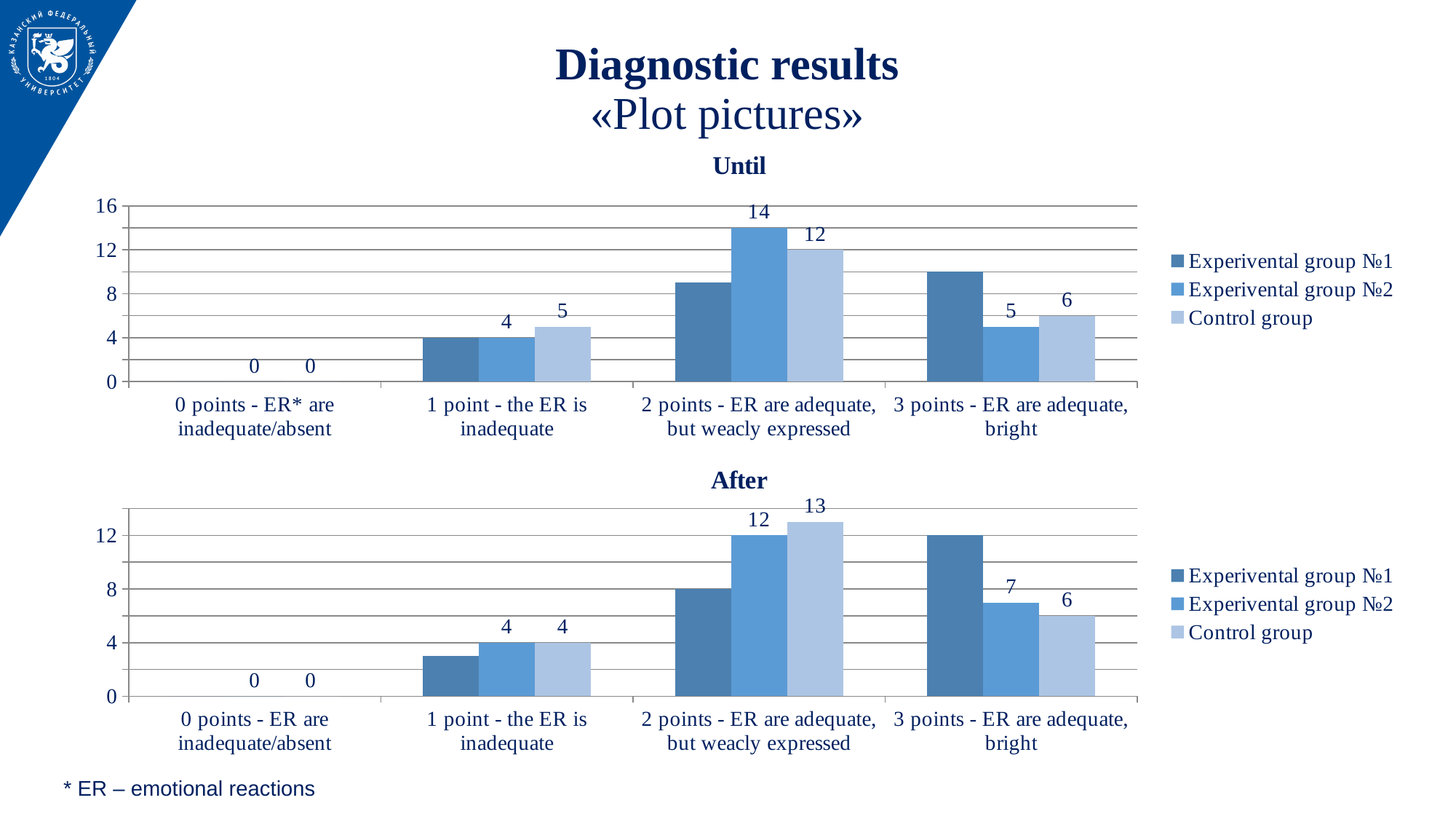
In the "Until" chart, what is the value for the Control group in the "3 points - ER are adequate, bright" category? 6 How many series does the legend of the "Until" chart list? 3 In the "Until" chart, is the value for Experimental group №1 in the "2 points - ER are adequate, but weacly expressed" category greater or less than 8? greater In the "After" chart, which is larger in the "3 points - ER are adequate, bright" category: Experimental group №2 or the Control group? Experimental group №2 In the "Until" chart, what is the difference between Experimental group №2 and the Control group in the "2 points - ER are adequate, but weacly expressed" category? 2 In the "Until" chart, what is the value for Experimental group №2 in the "2 points - ER are adequate, but weacly expressed" category? 14 In the "Until" chart, which category has the highest value for Experimental group №2? 2 points - ER are adequate, but weacly expressed In the "After" chart, is the value for Experimental group №1 in the "1 point - the ER is inadequate" category greater or less than 4? less In the "After" chart, what is the value for the Control group in the "2 points - ER are adequate, but weacly expressed" category? 13 What kind of chart is the "After" chart? bar chart How many categories are shown on the x axis of the "After" chart? 4 In the "After" chart, what is the value for Experimental group №2 in the "3 points - ER are adequate, bright" category? 7